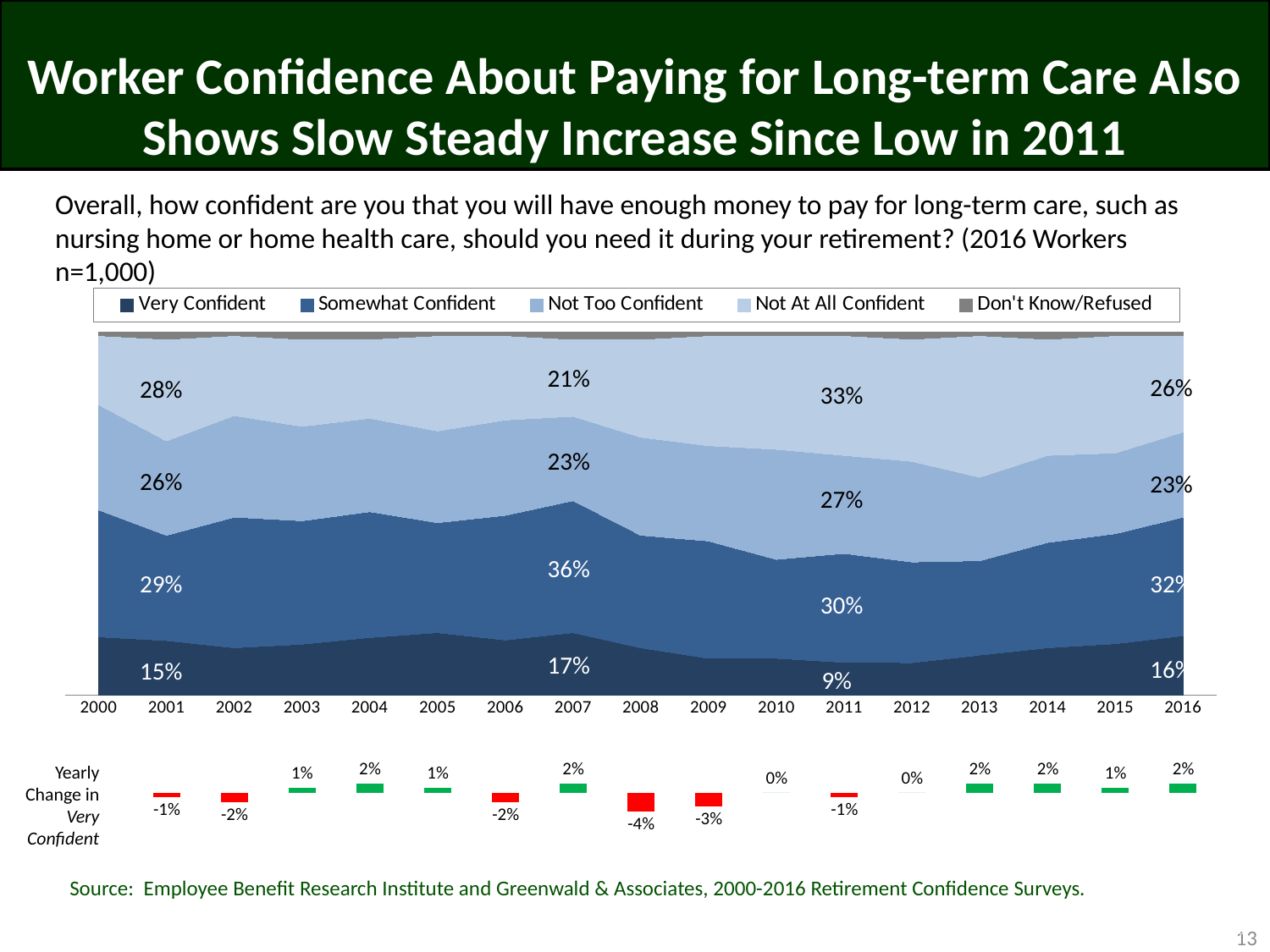
In the Yearly Change in Very Confident chart, what is the value for 2009? -3% What percentage of workers were Not Too Confident in 2016? 23% By how many percentage points did the Very Confident share differ between 2007 and 2011? 8 percentage points In the Yearly Change in Very Confident chart, which year shows the largest decrease? 2008 How many years are shown on the x axis of the main chart? 17 How many series does the legend of the main chart list? 5 What percentage of workers were Very Confident in 2011? 9% What percentage of workers were Very Confident in 2001? 15% What percentage of workers were Not At All Confident in 2011? 33% Which was larger in 2016: the Somewhat Confident share or the Not At All Confident share? Somewhat Confident What kind of chart is the main chart showing confidence levels? Stacked area chart What percentage of workers were Somewhat Confident in 2007? 36%